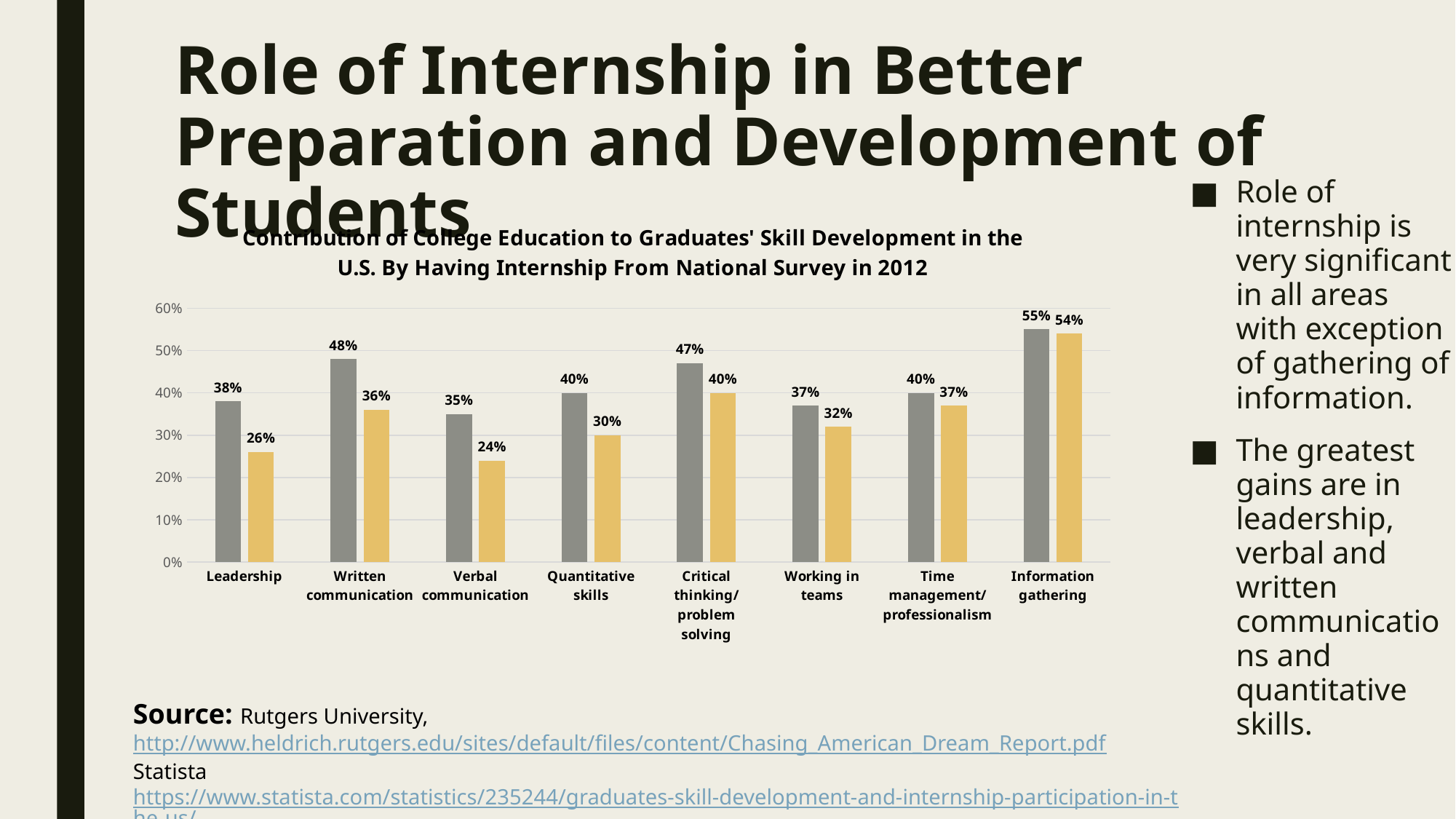
How many categories are shown on the x axis? 8 What is the title of the chart? Contribution of College Education to Graduates' Skill Development in the U.S. By Having Internship From National Survey in 2012 Which category has the lowest yellow bar? Verbal communication Which category has the highest gray bar? Information gathering Which is larger: the yellow bar for Quantitative skills or the yellow bar for Working in teams? Working in teams What is the value of the yellow bar for Verbal communication? 24% What is the value of the gray bar for Critical thinking/problem solving? 47% What is the difference between the gray and yellow bars for Written communication? 12% What is the difference between the gray and yellow bars for Information gathering? 1% What type of chart is shown on the slide? bar chart What is the value of the gray bar for Leadership? 38% How many bars are plotted for each category? 2